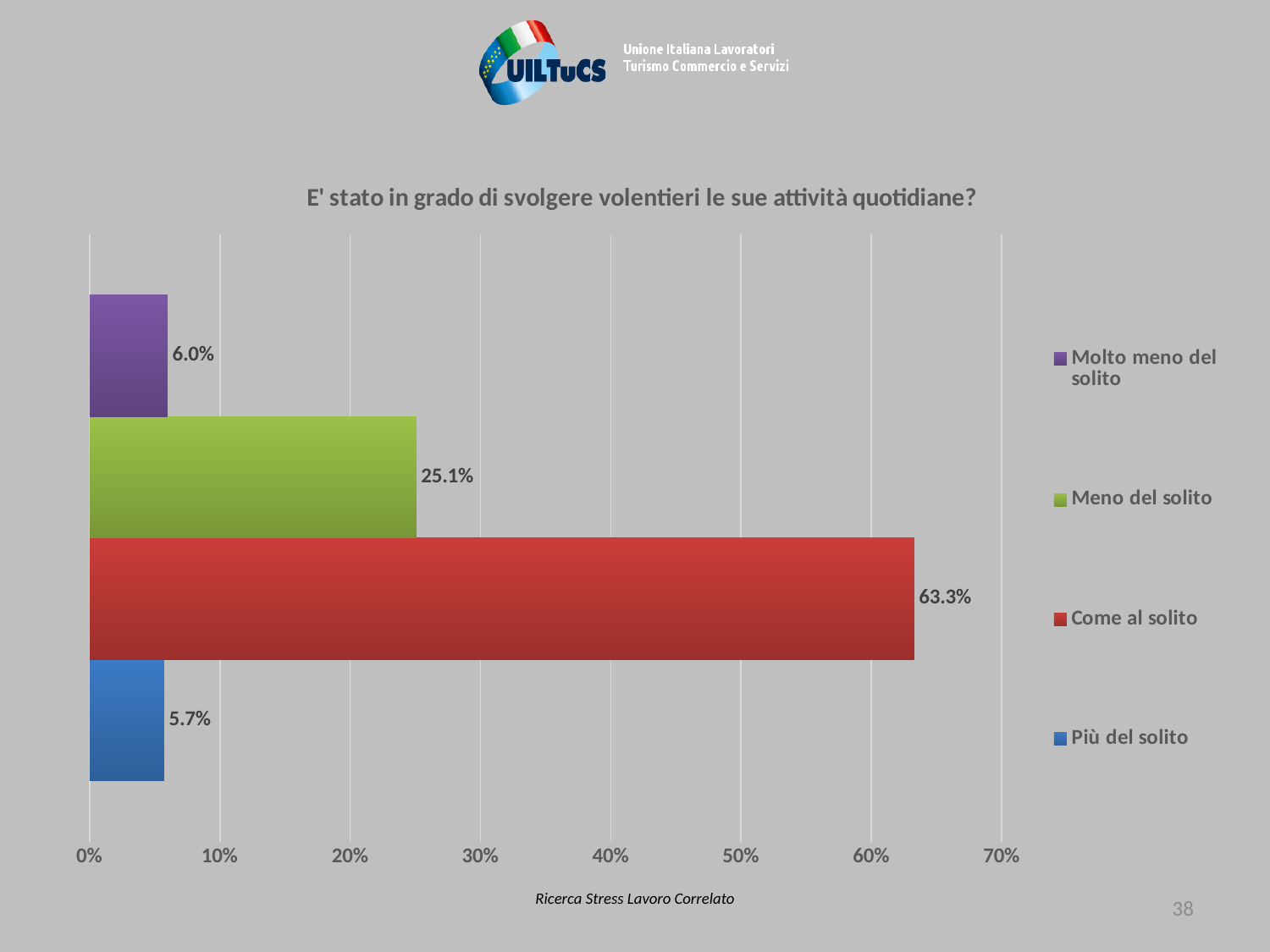
What is the title of the chart? E' stato in grado di svolgere volentieri le sue attività quotidiane? What is the value for "Come al solito"? 63.3% What is the difference between the values for "Come al solito" and "Meno del solito"? 38.2% Which category has the highest value? Come al solito Is the value for "Come al solito" greater or less than 60%? greater What is the value for "Più del solito"? 5.7% Which category has the lowest value? Più del solito Which is larger, the value for "Meno del solito" or the value for "Molto meno del solito"? Meno del solito What is the value for "Molto meno del solito"? 6.0% What kind of chart is shown on the slide? bar chart How many categories does the legend list? 4 What is the value for "Meno del solito"? 25.1%